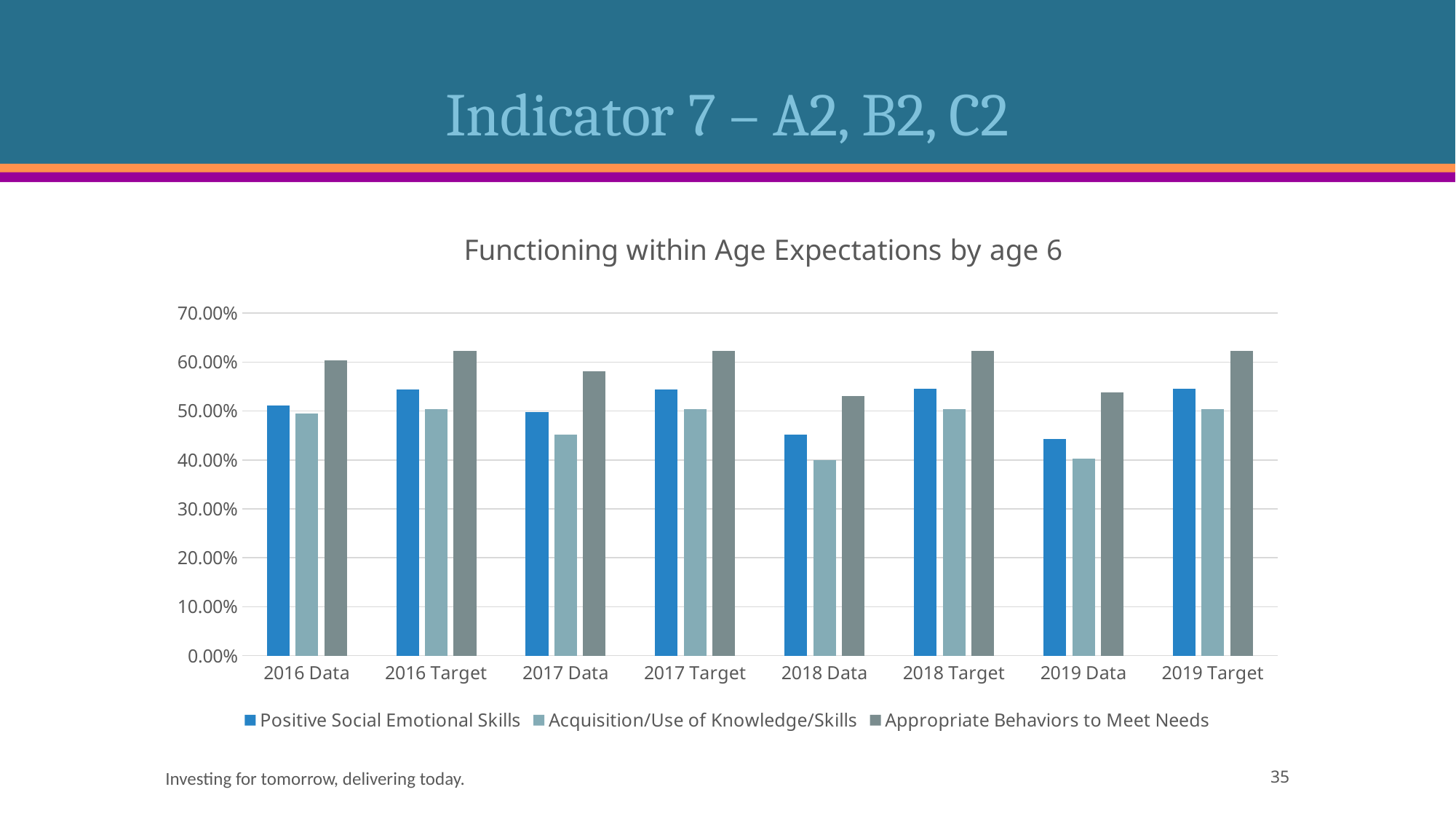
Is the Positive Social Emotional Skills value larger in 2016 Data or in 2018 Data? 2016 Data Is the value for Positive Social Emotional Skills in 2018 Data greater or less than 40.00%? greater Which series has the lowest value in the 2019 Data category? Acquisition/Use of Knowledge/Skills Is the value for Acquisition/Use of Knowledge/Skills in 2017 Data greater or less than 50.00%? less Do the Positive Social Emotional Skills values for the Data categories rise or fall from 2016 Data to 2019 Data? fall Which series has the highest value in the 2018 Data category? Appropriate Behaviors to Meet Needs What kind of chart is shown on the slide? bar chart How many categories are shown along the x axis? 8 How many series does the legend list? 3 What is the title of the chart? Functioning within Age Expectations by age 6 Is the value for Positive Social Emotional Skills in 2019 Data greater or less than 50.00%? less